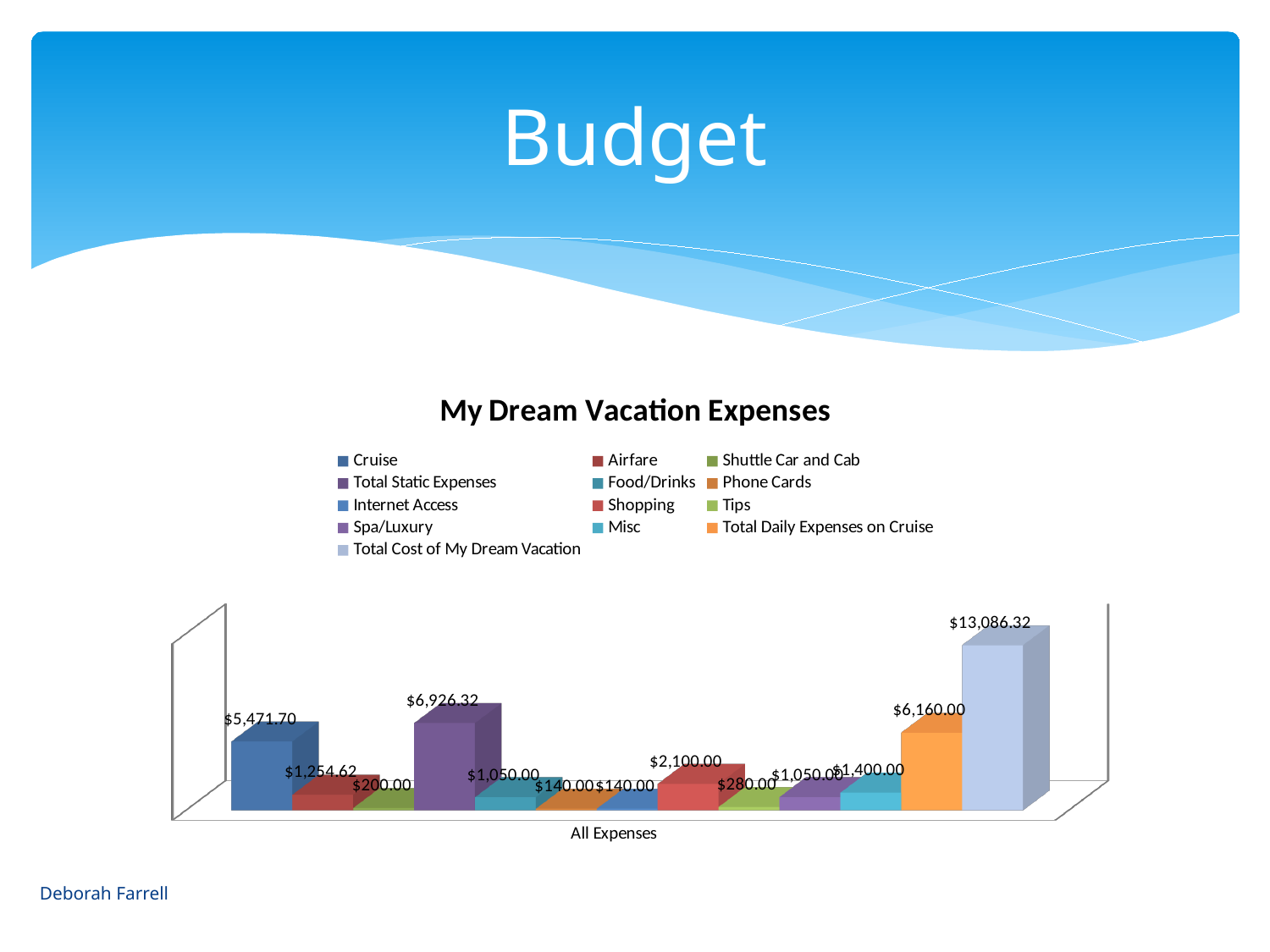
What is the value for Total Cost of My Dream Vacation? $13,086.32 What is the value for Total Daily Expenses on Cruise? $6,160.00 Which series has the highest value? Total Cost of My Dream Vacation What is the value for Shopping? $2,100.00 How many series does the legend list? 13 What kind of chart is shown on the slide? bar chart What is the label of the category on the x axis? All Expenses Which is larger, Cruise or Total Daily Expenses on Cruise? Total Daily Expenses on Cruise What is the title of the chart? My Dream Vacation Expenses What is the value for Cruise? $5,471.70 What is the difference between Total Static Expenses and Total Daily Expenses on Cruise? $766.32 What is the value for Total Static Expenses? $6,926.32